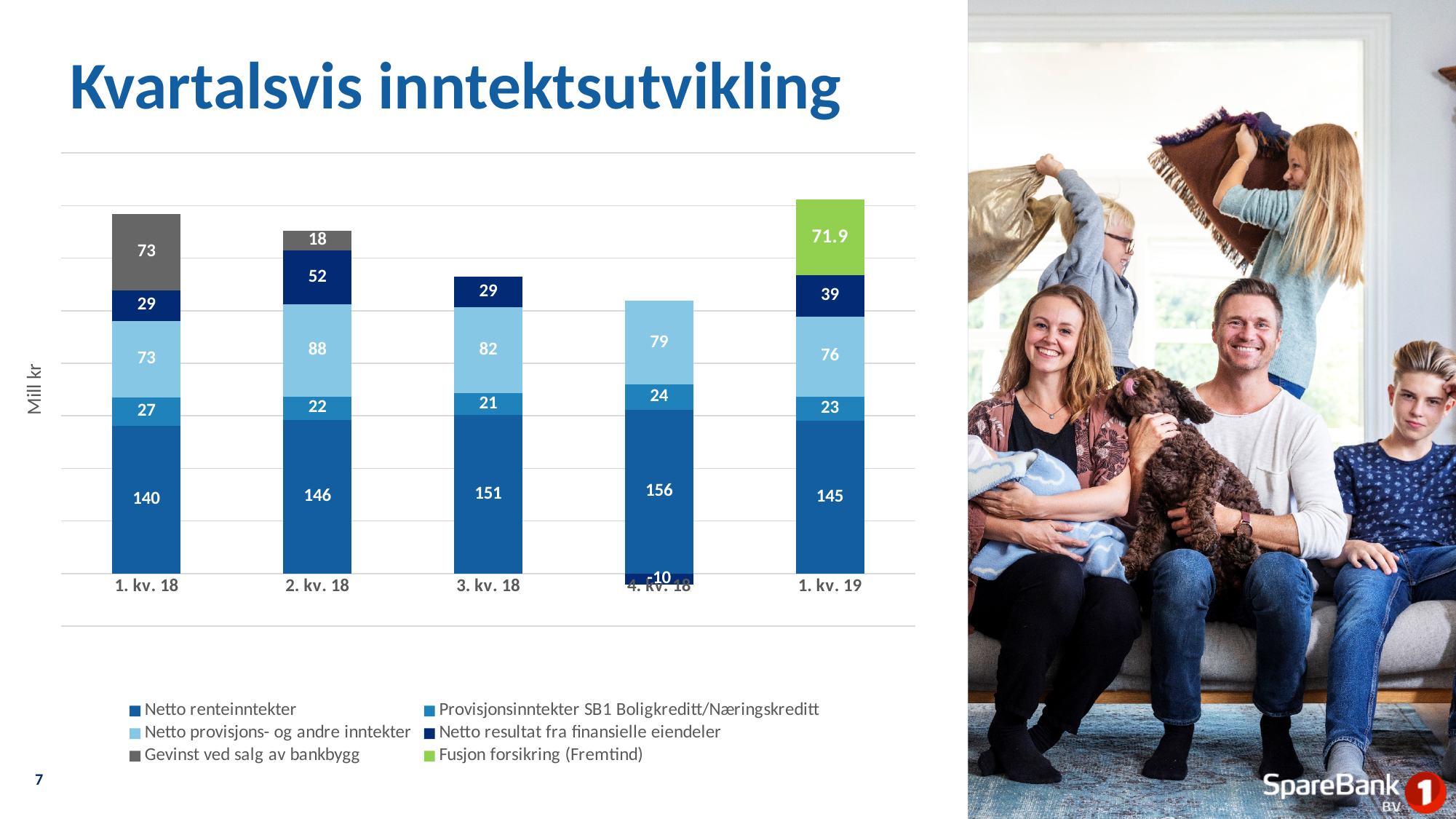
How many quarters are shown on the x axis of the chart? 5 Which is larger: Netto resultat fra finansielle eiendeler in 2. kv. 18 or in 1. kv. 19? 2. kv. 18 What is the difference between Netto renteinntekter in 4. kv. 18 and 1. kv. 18? 16 What is the total of the stacked bar for 3. kv. 18? 283 What is the value of Netto resultat fra finansielle eiendeler in 4. kv. 18? -10 What is the value of Fusjon forsikring (Fremtind) in 1. kv. 19? 71.9 What is the value of Netto provisjons- og andre inntekter in 2. kv. 18? 88 How many series does the legend list? 6 What is the value of Netto renteinntekter in 3. kv. 18? 151 What type of chart is shown on the slide? Stacked bar chart In which quarter is Provisjonsinntekter SB1 Boligkreditt/Næringskreditt lowest? 3. kv. 18 In which quarter is Netto renteinntekter highest? 4. kv. 18